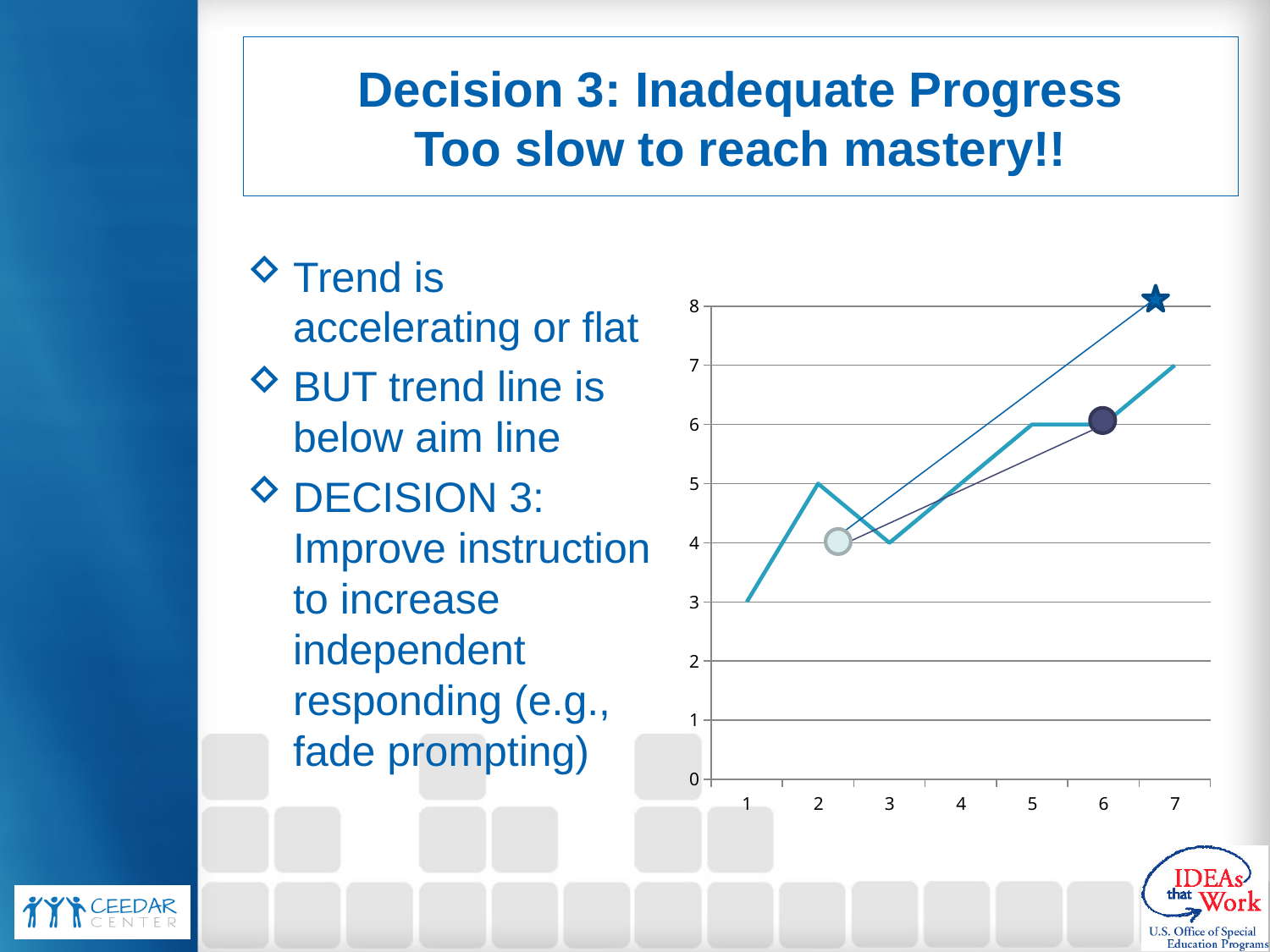
What is the value of the teal data line at x = 2? 5 How many tick labels are shown on the x axis? 7 Overall, does the teal data line rise or fall from x = 1 to x = 7? rise Is the value of the teal data line at x = 5 greater or less than 5? greater Is the value of the teal data line at x = 1 greater or less than 4? less Which is larger, the teal data line's value at x = 2 or at x = 3? x = 2 What is the value of the teal data line at x = 7? 7 At which x value does the teal data line have its lowest point? 1 What kind of chart is shown on the slide? line chart What is the value of the teal data line at x = 3? 4 At which x value does the teal data line reach its highest point? 7 What is the value of the teal data line at x = 1? 3